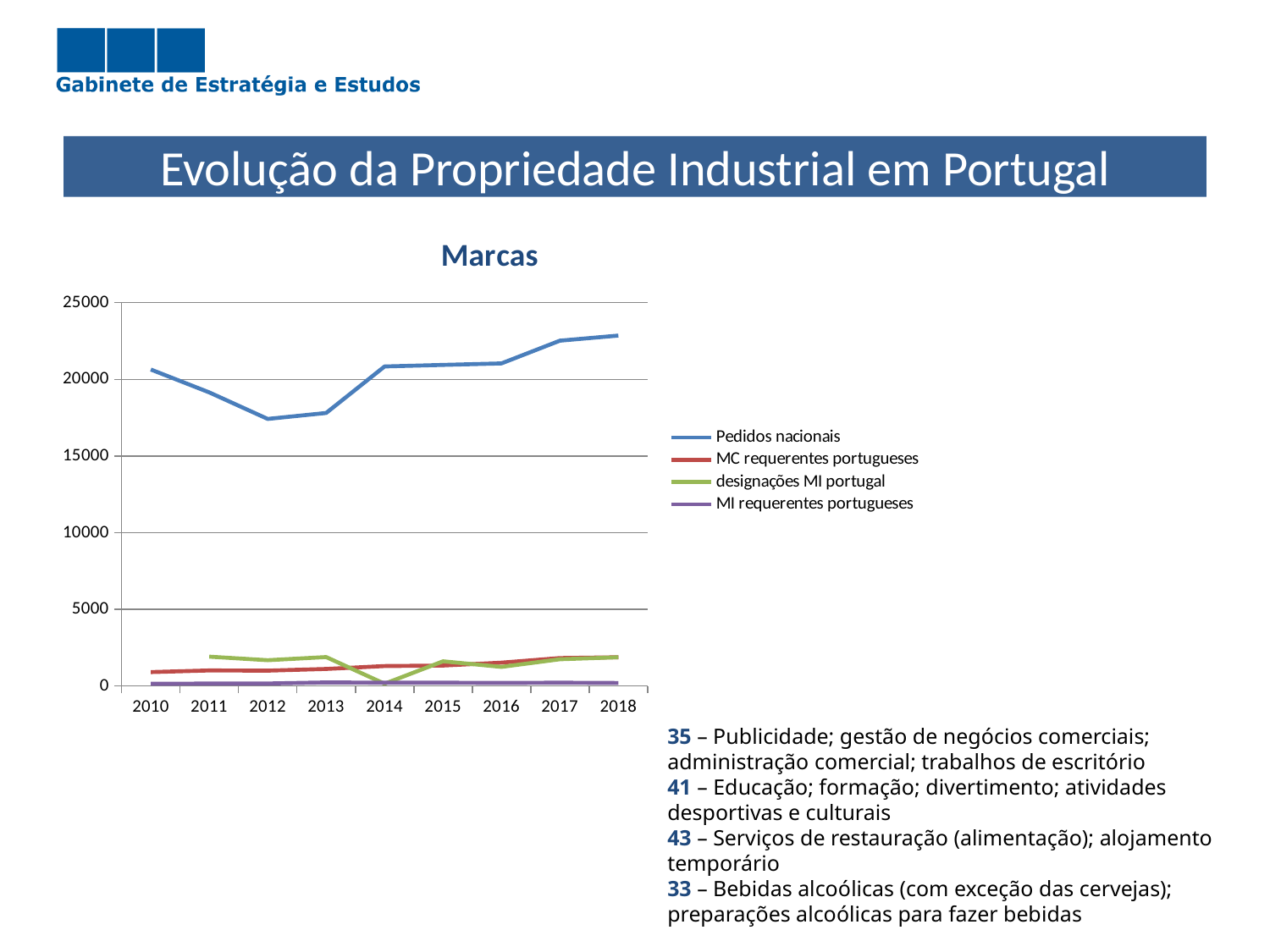
Does the Pedidos nacionais series rise or fall between 2014 and 2018? rise Is the value for Pedidos nacionais in 2018 greater or less than 20000? greater How many series does the legend of the chart list? 4 How many years are shown on the x axis of the chart? 9 Which is larger in 2018: Pedidos nacionais or MC requerentes portugueses? Pedidos nacionais Which series has the highest values throughout the chart? Pedidos nacionais Is the value for MC requerentes portugueses in 2018 greater or less than 5000? less In which year does the Pedidos nacionais series reach its highest value? 2018 Is the value for Pedidos nacionais in 2012 greater or less than 20000? less What kind of chart is shown on the slide? line chart What is the title of the chart? Marcas